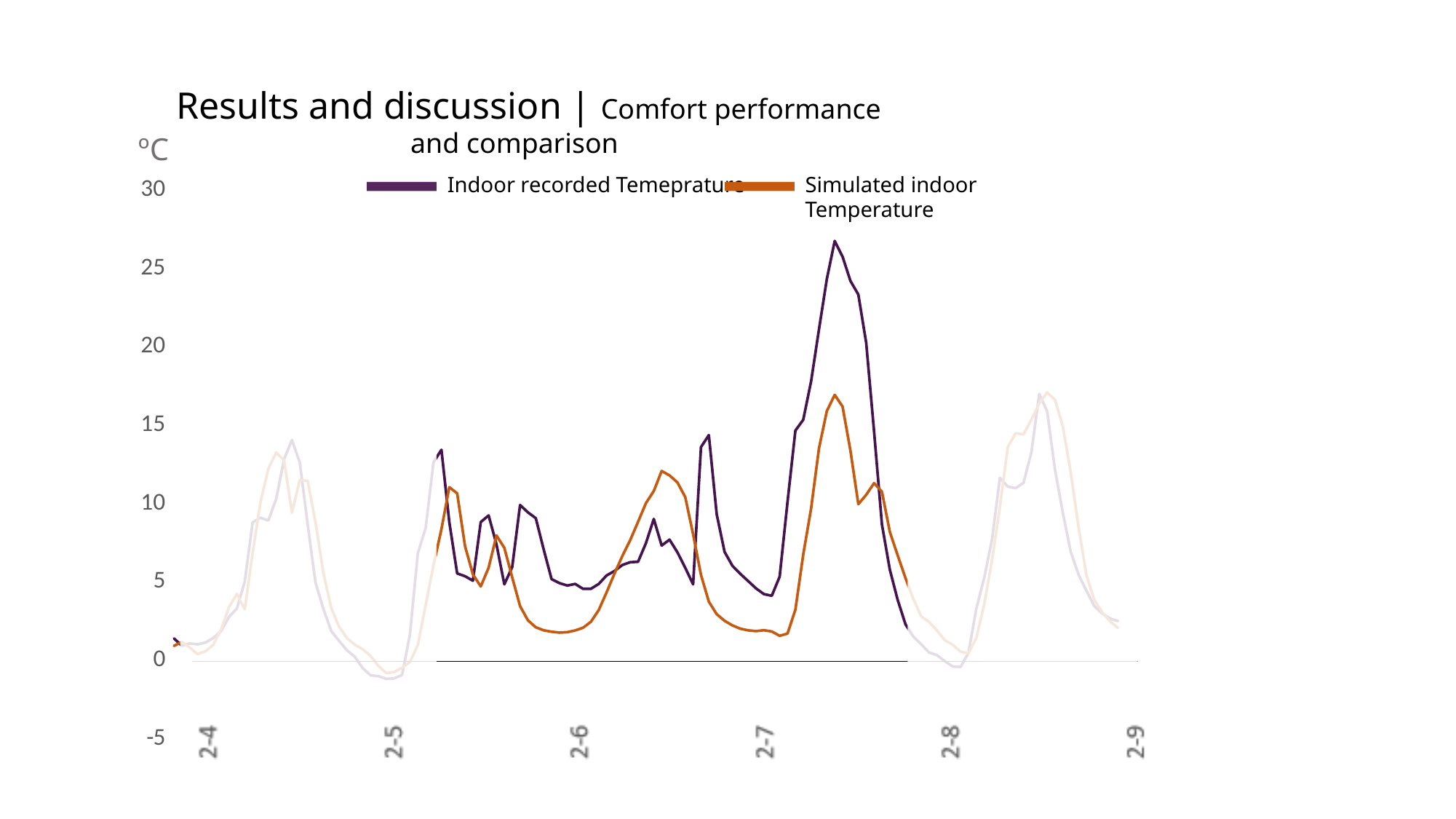
Is the highest value of the Simulated indoor Temperature series greater or less than 20? less How many series does the legend list? 2 What are the two series named in the legend? Indoor recorded Temeprature and Simulated indoor Temperature Which series reaches the highest value on the chart? Indoor recorded Temeprature Is the highest value of the Indoor recorded Temeprature series greater or less than 25? greater How many date labels are shown on the x axis? 6 At the peak shortly after 2-7, which series has the larger value, Indoor recorded Temeprature or Simulated indoor Temperature? Indoor recorded Temeprature Is the lowest value of the Simulated indoor Temperature series between 2-5 and 2-8 greater or less than 5? less What is the lowest value labelled on the y axis? -5 What unit is shown on the y axis? °C What kind of chart is shown on the slide? line chart